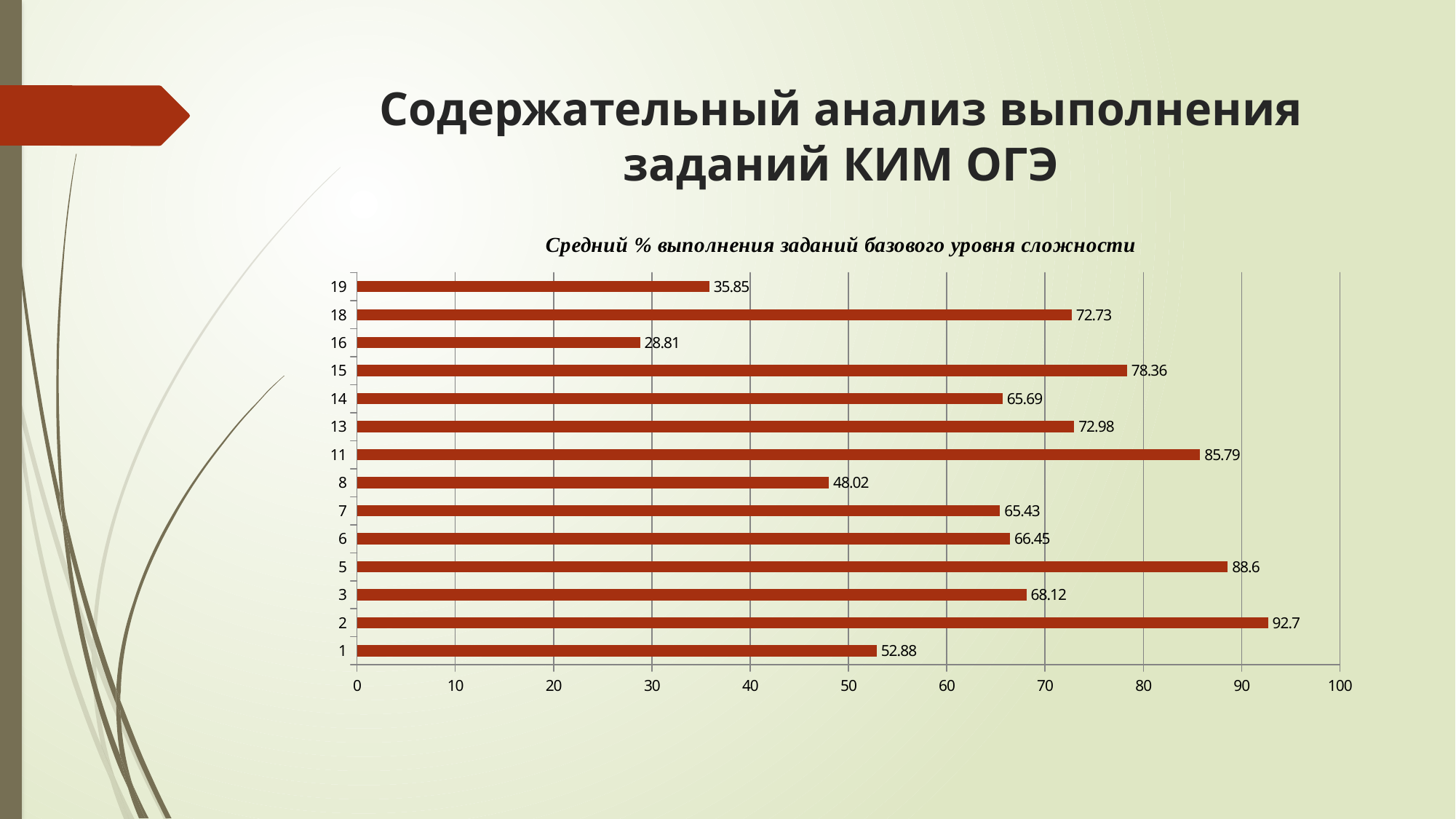
How many tasks (bars) are shown in the chart? 14 What is the value for task 16 in the chart? 28.81 What is the title of the chart? Средний % выполнения заданий базового уровня сложности What is the difference between the values for task 5 and task 11? 2.81 What is the value for task 1 in the chart? 52.88 Which task has the highest value in the chart? 2 Is the value for task 8 greater or less than 50? less What is the difference between the values for task 2 and task 16? 63.89 Which has a larger value, task 15 or task 18? task 15 What kind of chart is shown on the slide? bar chart Which task has the lowest value in the chart? 16 What is the value for task 11 in the chart? 85.79